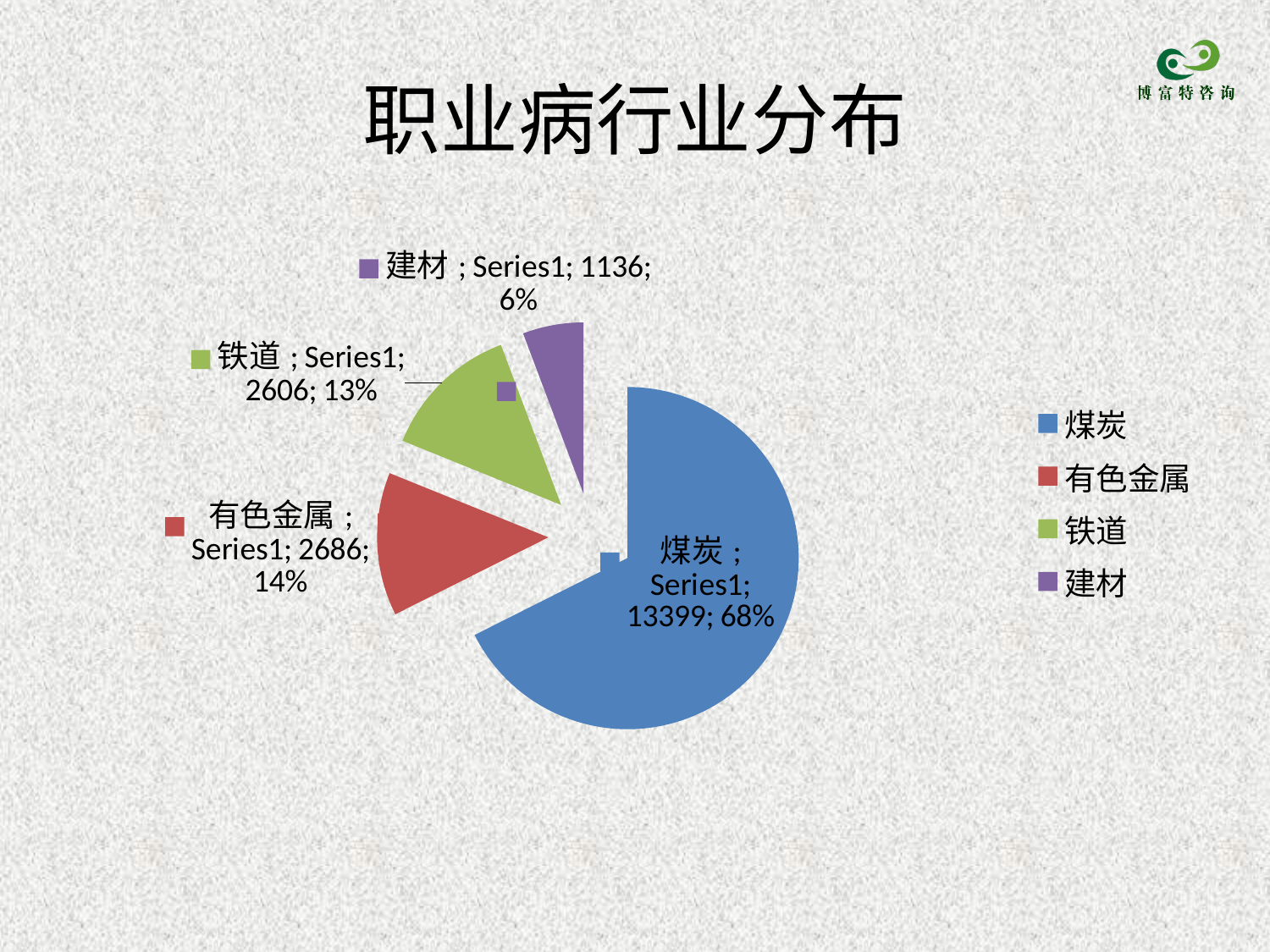
Which category has the smallest slice? 建材 What share of the pie does 建材 take? 6% What is the value for 铁道? 2606 What kind of chart is shown on the slide? pie chart What is the value for 有色金属? 2686 What is the difference between the values for 有色金属 and 铁道? 80 How many categories does the pie chart have? 4 What is the value for 煤炭? 13399 What is the title of the chart? 职业病行业分布 Which category has the largest slice? 煤炭 What is the value for 建材? 1136 What share of the pie does 煤炭 take? 68%